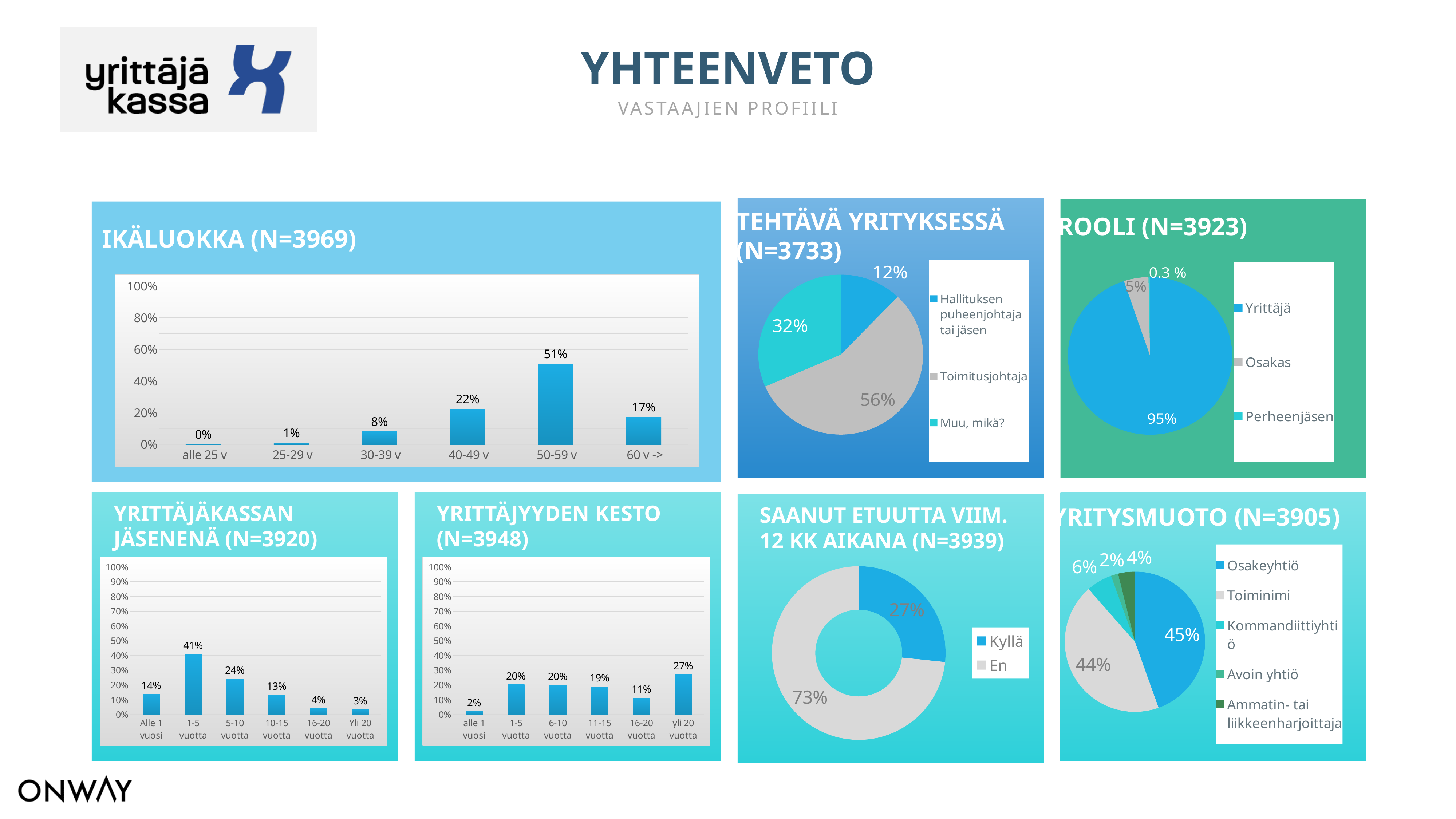
In the YRITTÄJYYDEN KESTO (N=3948) chart, which is larger, the value for 16-20 vuotta or yli 20 vuotta? yli 20 vuotta In the ROOLI (N=3923) pie chart, what is the value for Perheenjäsen? 0.3 % In the YRITTÄJÄKASSAN JÄSENENÄ (N=3920) chart, which category has the highest value? 1-5 vuotta In the SAANUT ETUUTTA VIIM. 12 KK AIKANA (N=3939) chart, what share answered Kyllä? 27% In the IKÄLUOKKA (N=3969) chart, which age group has the lowest value? alle 25 v In the IKÄLUOKKA (N=3969) chart, what is the value for 50-59 v? 51% In the YRITTÄJÄKASSAN JÄSENENÄ (N=3920) chart, how many categories are shown on the x axis? 6 How many series does the legend of the TEHTÄVÄ YRITYKSESSÄ (N=3733) chart list? 3 In the YRITYSMUOTO (N=3905) pie chart, what is the value for Kommandiittiyhtiö? 6% In the TEHTÄVÄ YRITYKSESSÄ (N=3733) pie chart, what share is Toimitusjohtaja? 56% What kind of chart is the YRITTÄJYYDEN KESTO (N=3948) chart? bar chart In the IKÄLUOKKA (N=3969) chart, what is the difference between the values for 40-49 v and 60 v ->? 5%